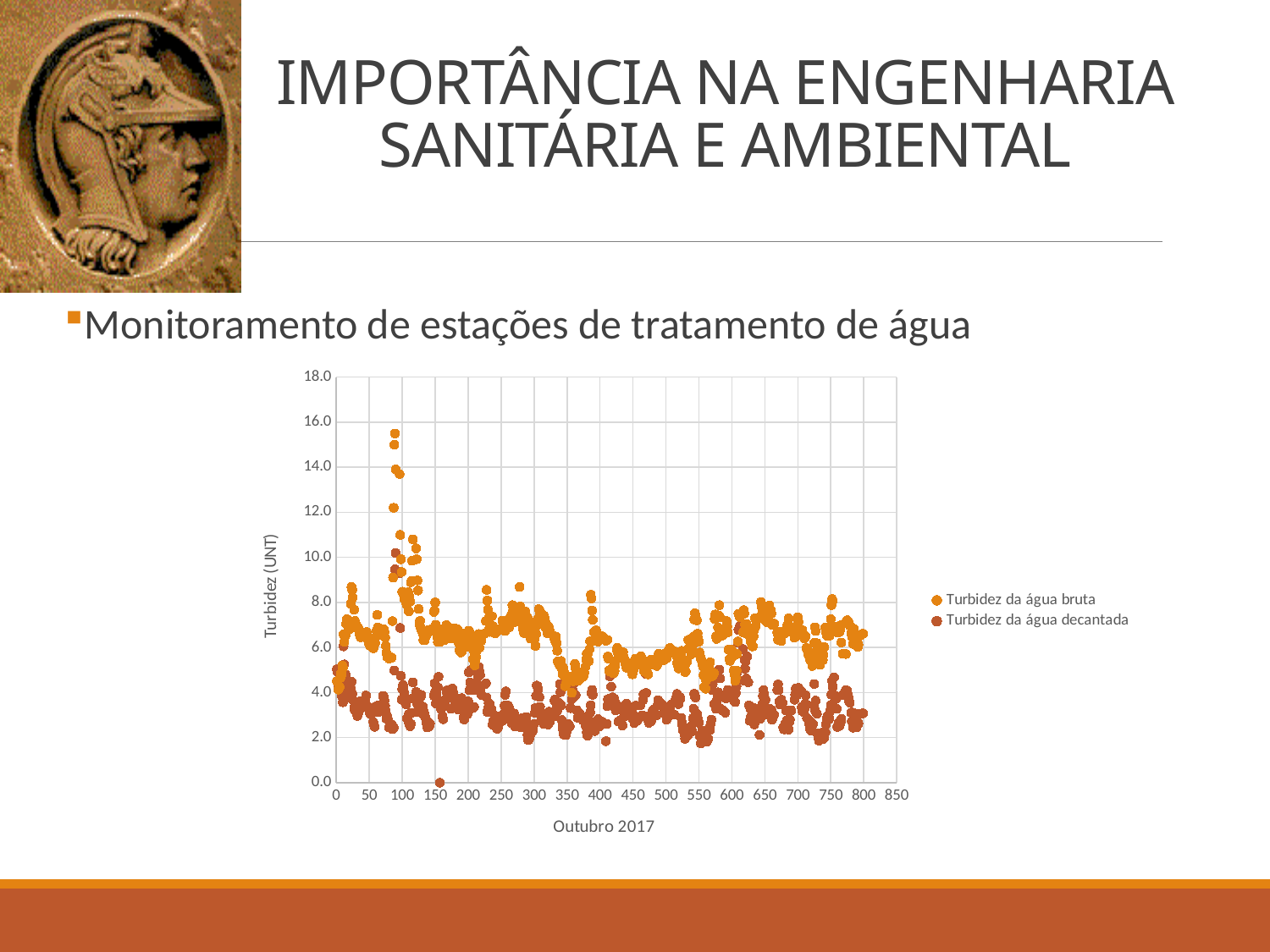
What are the two series named in the legend? Turbidez da água bruta and Turbidez da água decantada Is the highest point plotted on the chart greater or less than 16.0? less Is the lowest value of Turbidez da água decantada greater or less than 2.0? less Are the Turbidez da água bruta values between x = 400 and x = 500 greater or less than 10.0? less Which series generally has higher values, Turbidez da água bruta or Turbidez da água decantada? Turbidez da água bruta What kind of chart is shown on the slide? scatter chart How many series does the legend list? 2 What is the title of the vertical axis? Turbidez (UNT)